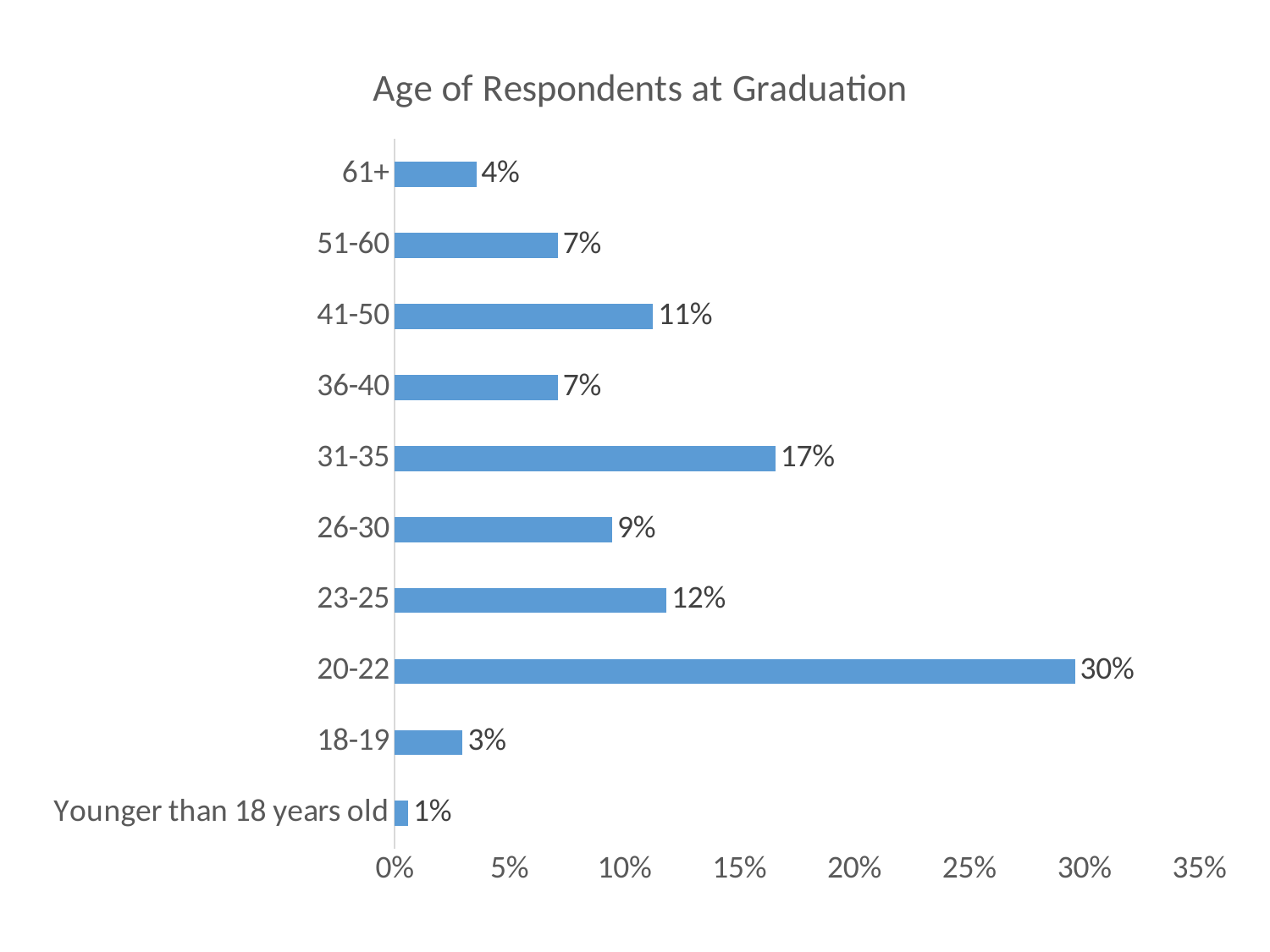
Which age group has the lowest percentage of respondents? Younger than 18 years old What percentage of respondents were aged 20-22 at graduation? 30% What is the highest value shown on the horizontal axis? 35% Is the value for 31-35 greater or less than 15%? greater How many age categories are shown in the chart? 10 What is the value for the 31-35 age group? 17% What percentage of respondents were younger than 18 years old at graduation? 1% What is the difference between the 20-22 and 23-25 age groups? 18% Which age group has the highest percentage of respondents? 20-22 What kind of chart is this? Bar chart Which is larger, the value for 41-50 or the value for 26-30? 41-50 What is the title of the chart? Age of Respondents at Graduation